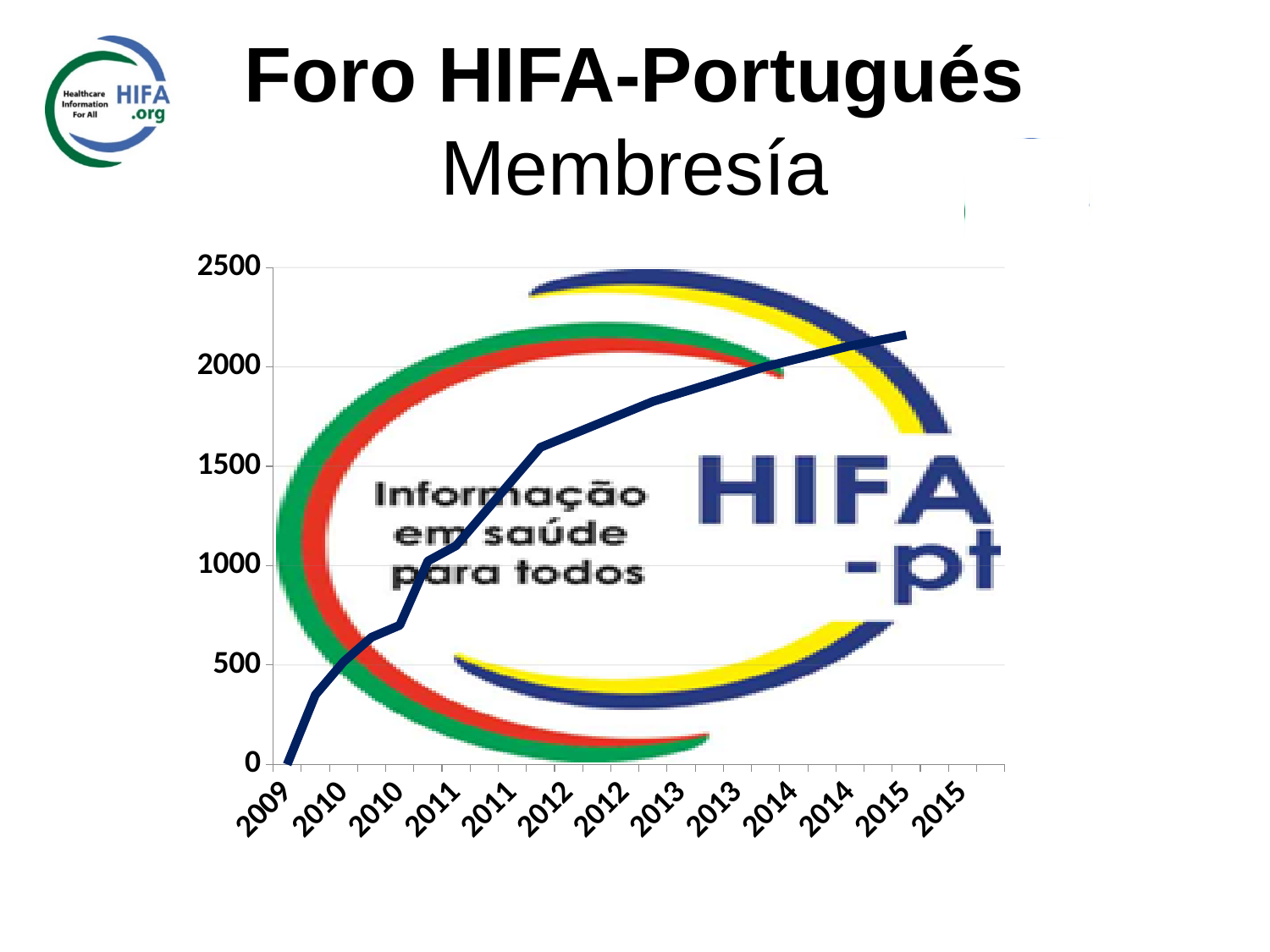
Which x-axis label has the lowest value in the chart? 2009 Is the value at the last point of the line (2015) greater or less than 2000? greater Is the value at the first 2011 label greater or less than 1000? greater How many year labels are shown along the x axis of the chart? 13 What is the highest value shown on the y axis of the chart? 2500 Is the value at the first 2012 label greater or less than 1500? greater Which x-axis label has the highest value in the chart? 2015 (the last point) What kind of chart is shown on the slide? line chart Do the values in the chart rise or fall from 2009 to 2015? rise